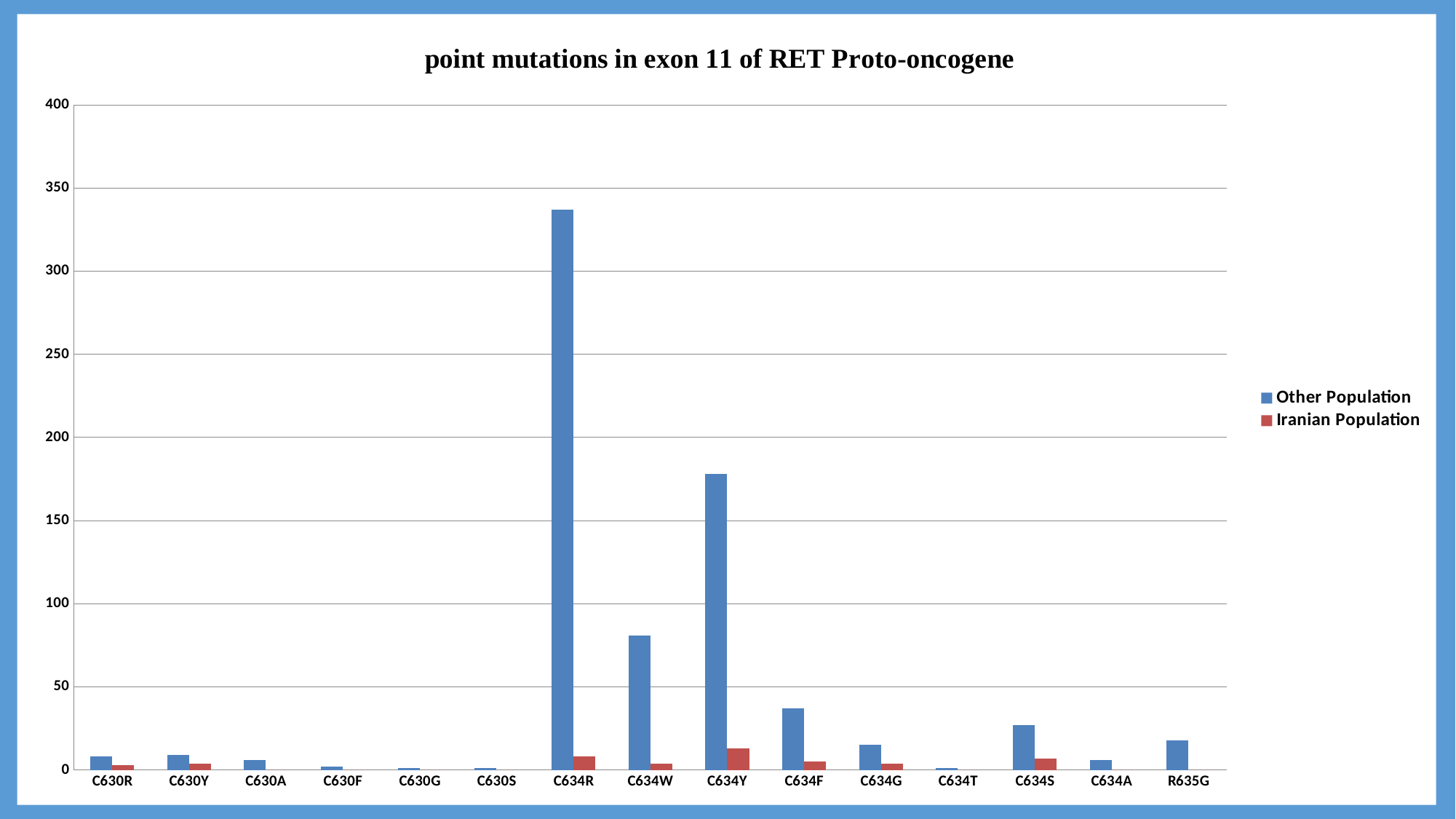
Which colour represents the Iranian Population series? red Is the Other Population value for C634R greater or less than 300? greater Which mutation has the highest value for Iranian Population? C634Y Is the Other Population value for C634F greater or less than 50? less What type of chart is shown on the slide? bar chart How many series does the legend list? 2 Which mutation has the highest value for Other Population? C634R Is the Other Population value for C634Y greater or less than 150? greater How many mutation categories are shown on the x axis? 15 For Other Population, which is larger: C634W or C634Y? C634Y What is the title of the chart? point mutations in exon 11 of RET Proto-oncogene